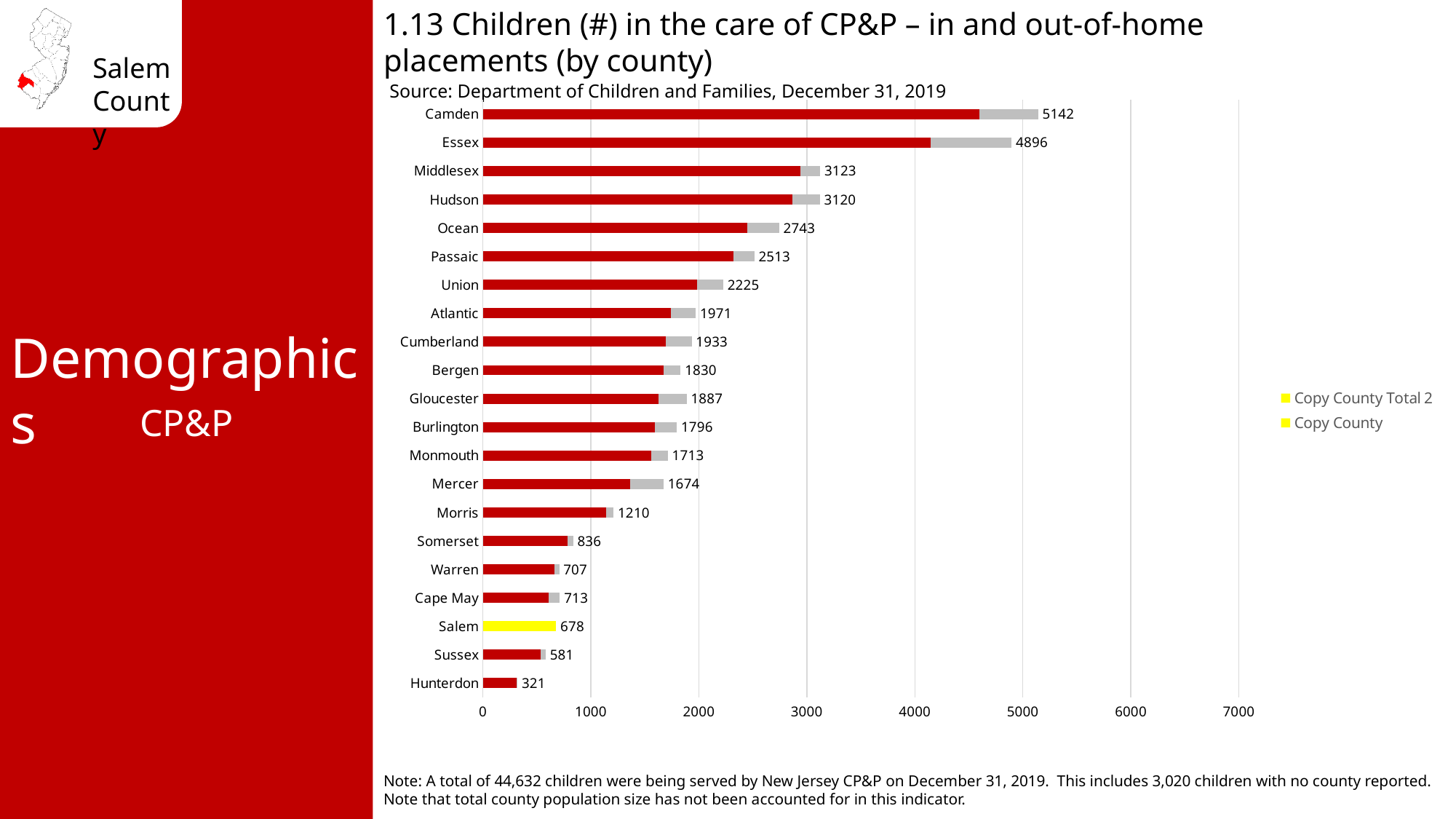
What is the total value shown for Camden? 5142 How many counties are shown on the chart? 21 How many entries does the legend list? 2 What type of chart is shown on the slide? Bar chart What is the difference between the totals for Salem and Hunterdon? 357 Which has a larger total, Gloucester or Bergen? Gloucester What is the total value shown for Salem? 678 Which county has the highest total number of children in the care of CP&P? Camden Is the red (in-home) portion of the Camden bar greater or less than 4000? greater Which county has the lowest total number of children in the care of CP&P? Hunterdon What is the total value shown for Hudson? 3120 What is the difference between the totals for Camden and Essex? 246